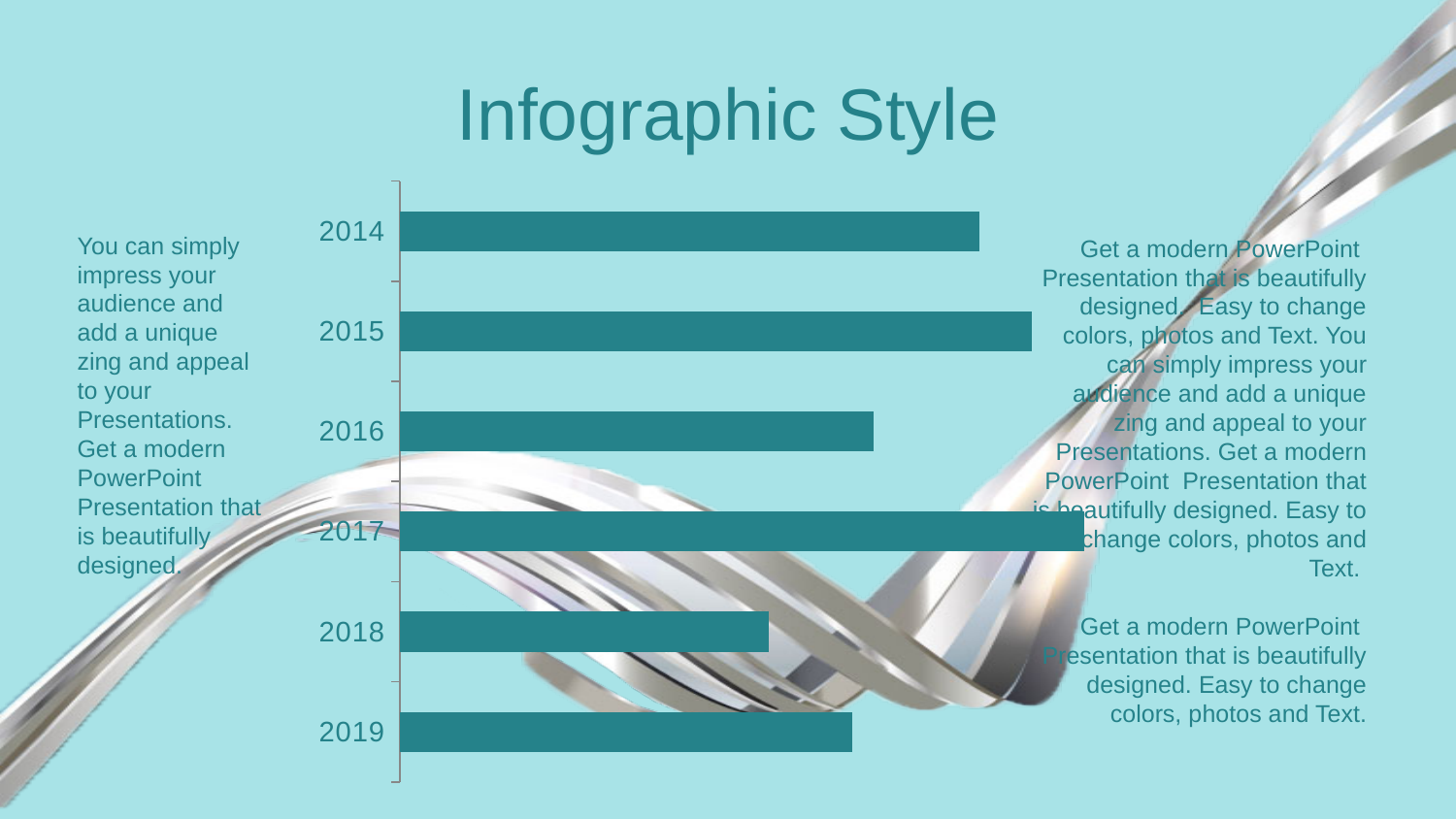
Which year is listed first (at the top) of the chart? 2014 How many categories (years) does the chart show? 6 Which has the larger value, 2015 or 2019? 2015 Which year has the shortest bar in the chart? 2018 Which has the larger value, 2016 or 2018? 2016 Which has the larger value, 2017 or 2018? 2017 Which year has the longest bar in the chart? 2017 What kind of chart is shown on the slide? bar chart Are the bars in the chart drawn horizontally or vertically? horizontally